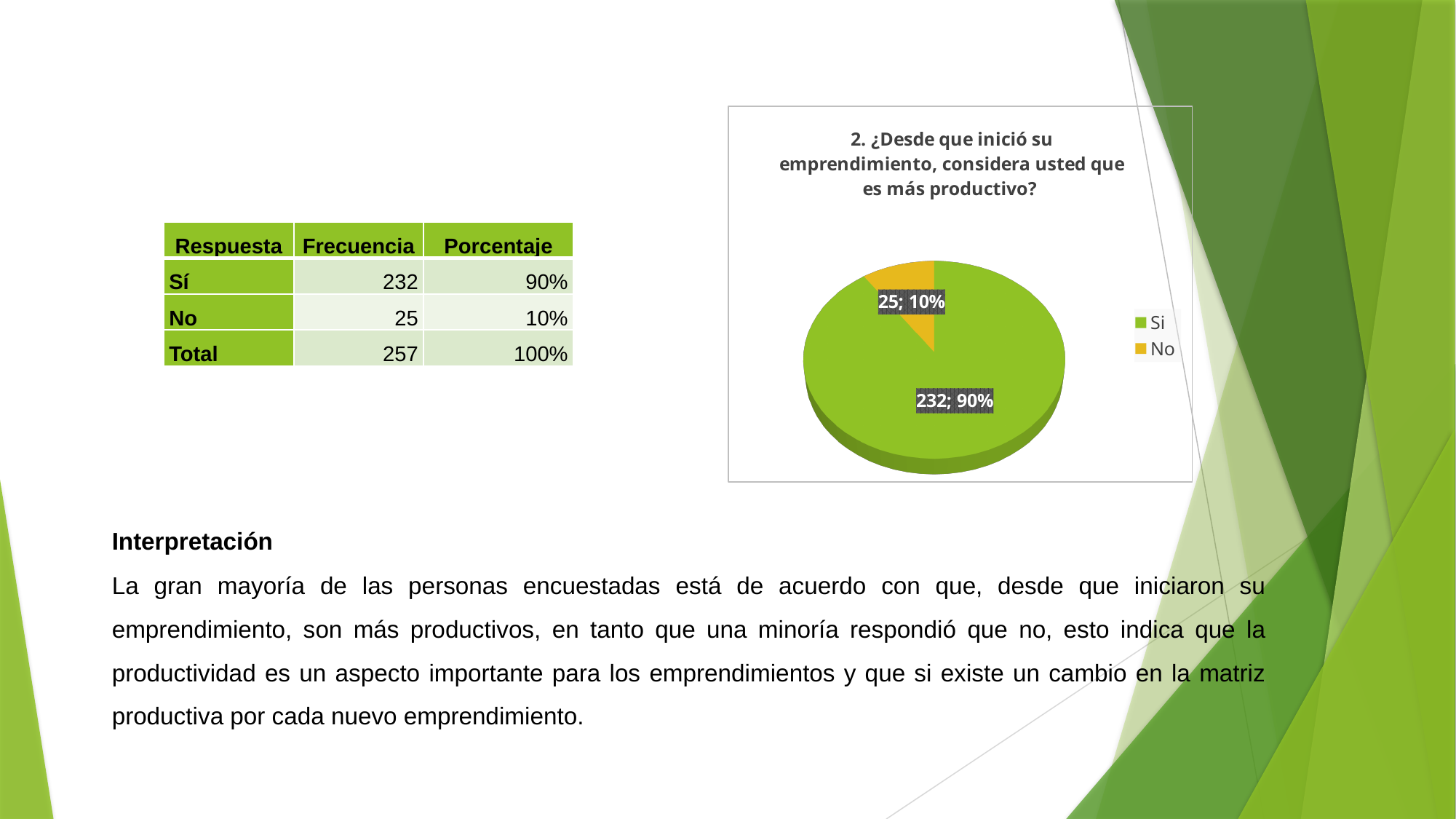
What share of the pie does the Si slice represent? 90% What is the difference between the Si and No values in the pie chart? 207 How many slices does the pie chart have? 2 Which is larger in the pie chart, Si or No? Si What share of the pie does the No slice represent? 10% What is the value for Si in the pie chart? 232 Which slice of the pie chart is the largest? Si What colour is the No slice in the pie chart? yellow What kind of chart is shown on the slide? pie chart What is the value for No in the pie chart? 25 How many entries does the legend of the pie chart list? 2 Which slice of the pie chart is the smallest? No